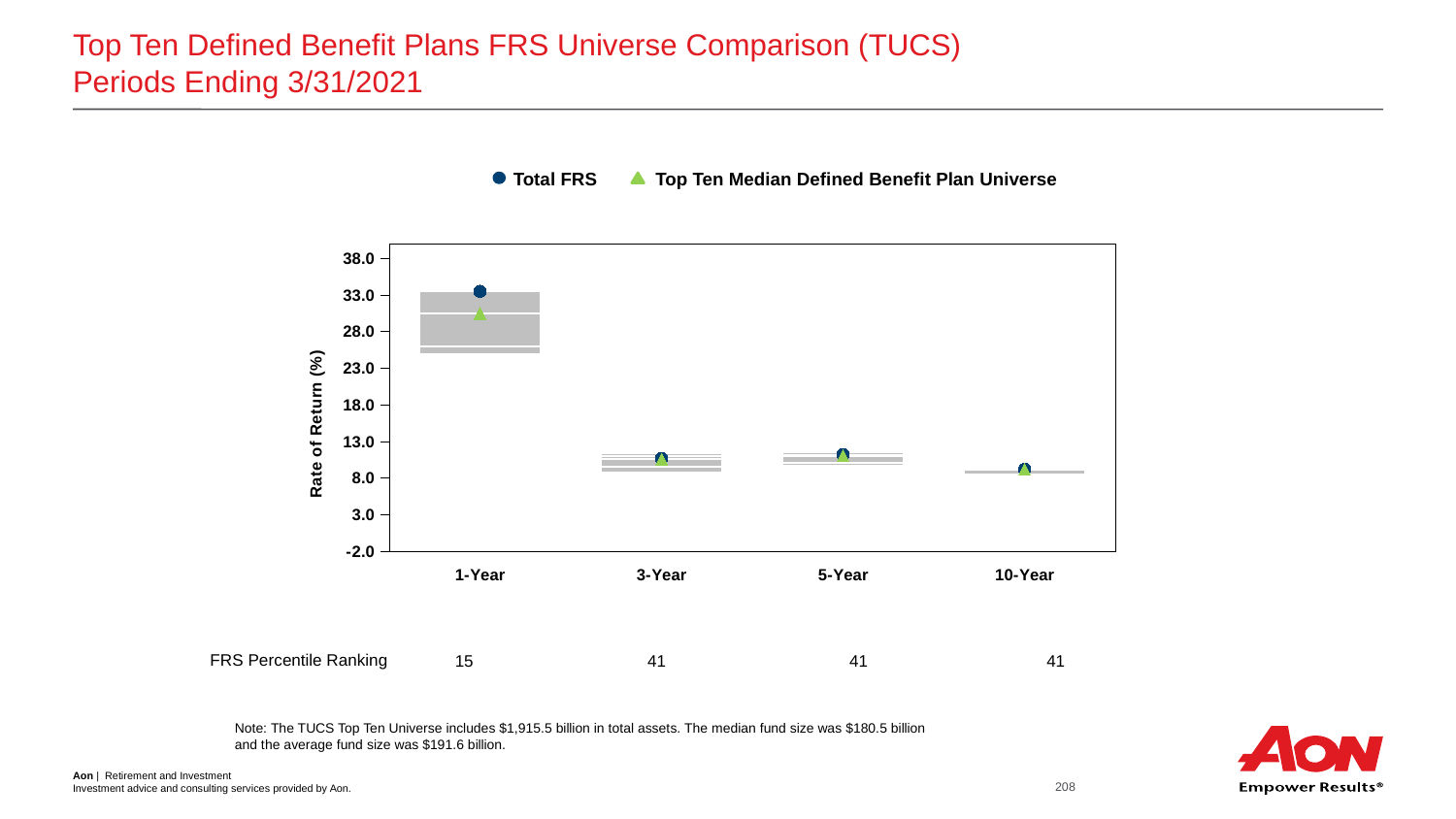
Is the Total FRS rate of return for 10-Year greater or less than 13.0? less Is the Total FRS rate of return for 3-Year greater or less than 8.0? greater What is the FRS Percentile Ranking for the 1-Year period? 15 Which period has the lowest Total FRS rate of return? 10-Year For the 1-Year period, which is higher: Total FRS or the Top Ten Median Defined Benefit Plan Universe? Total FRS How many series does the chart legend list? 2 What is the label on the y axis of the chart? Rate of Return (%) Is the Total FRS rate of return for 1-Year greater or less than 38.0? less Which period has the highest Total FRS rate of return? 1-Year Which is larger, the Total FRS rate of return for 1-Year or for 10-Year? 1-Year How many time periods are shown on the x axis of the chart? 4